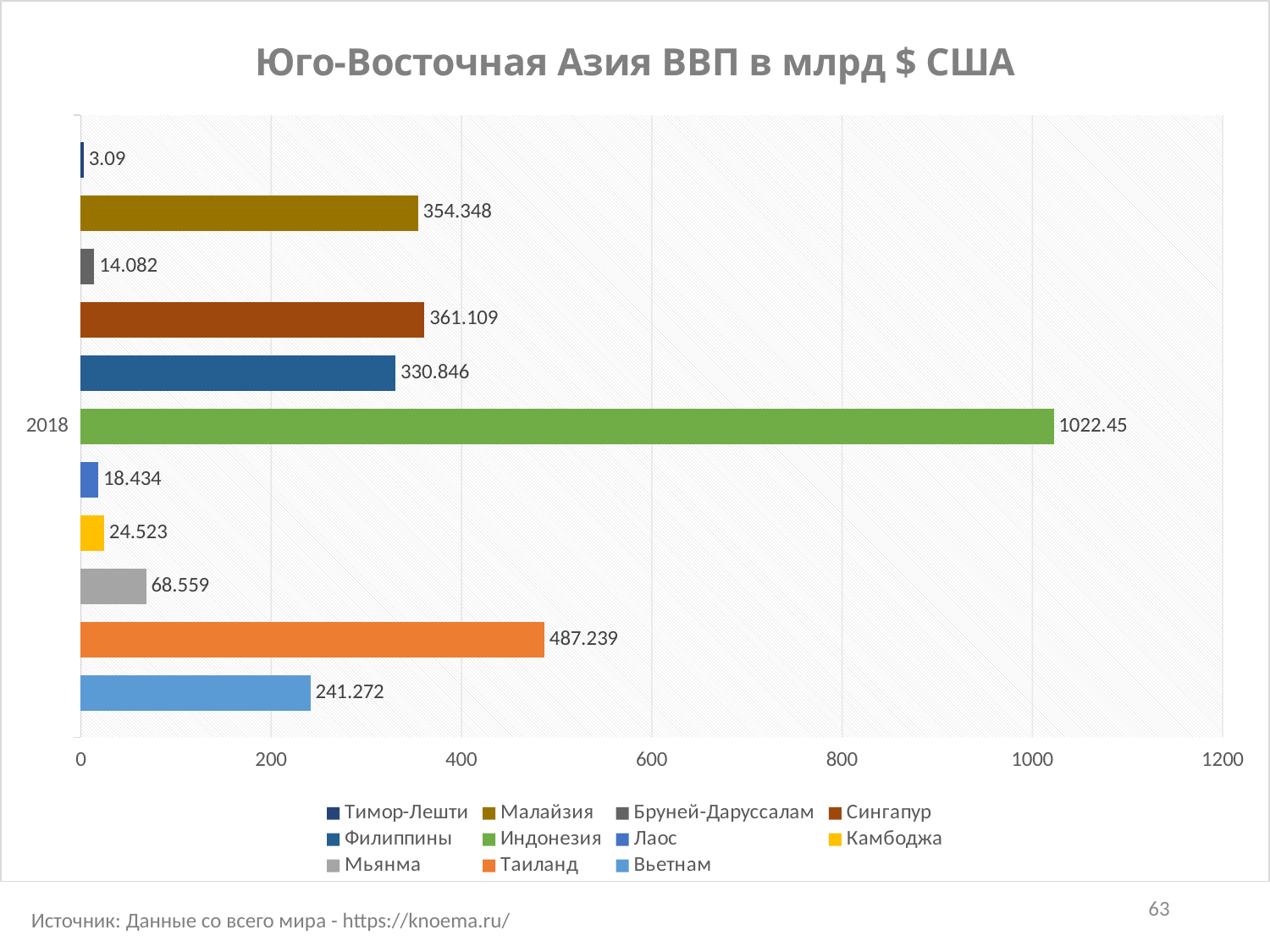
How many series does the legend list? 11 What kind of chart is shown on the slide? Bar chart Which has a larger GDP, Филиппины or Малайзия? Малайзия What is the title of the chart? Юго-Восточная Азия ВВП в млрд $ США What is the GDP value shown for Камбоджа? 24.523 What is the difference between the GDP of Таиланд and Вьетнам? 245.967 What is the GDP value shown for Таиланд? 487.239 Which country has the lowest GDP on the chart? Тимор-Лешти What is the difference between the GDP of Сингапур and Малайзия? 6.761 Which country has the highest GDP on the chart? Индонезия What is the GDP value shown for Индонезия? 1022.45 What is the GDP value shown for Вьетнам? 241.272